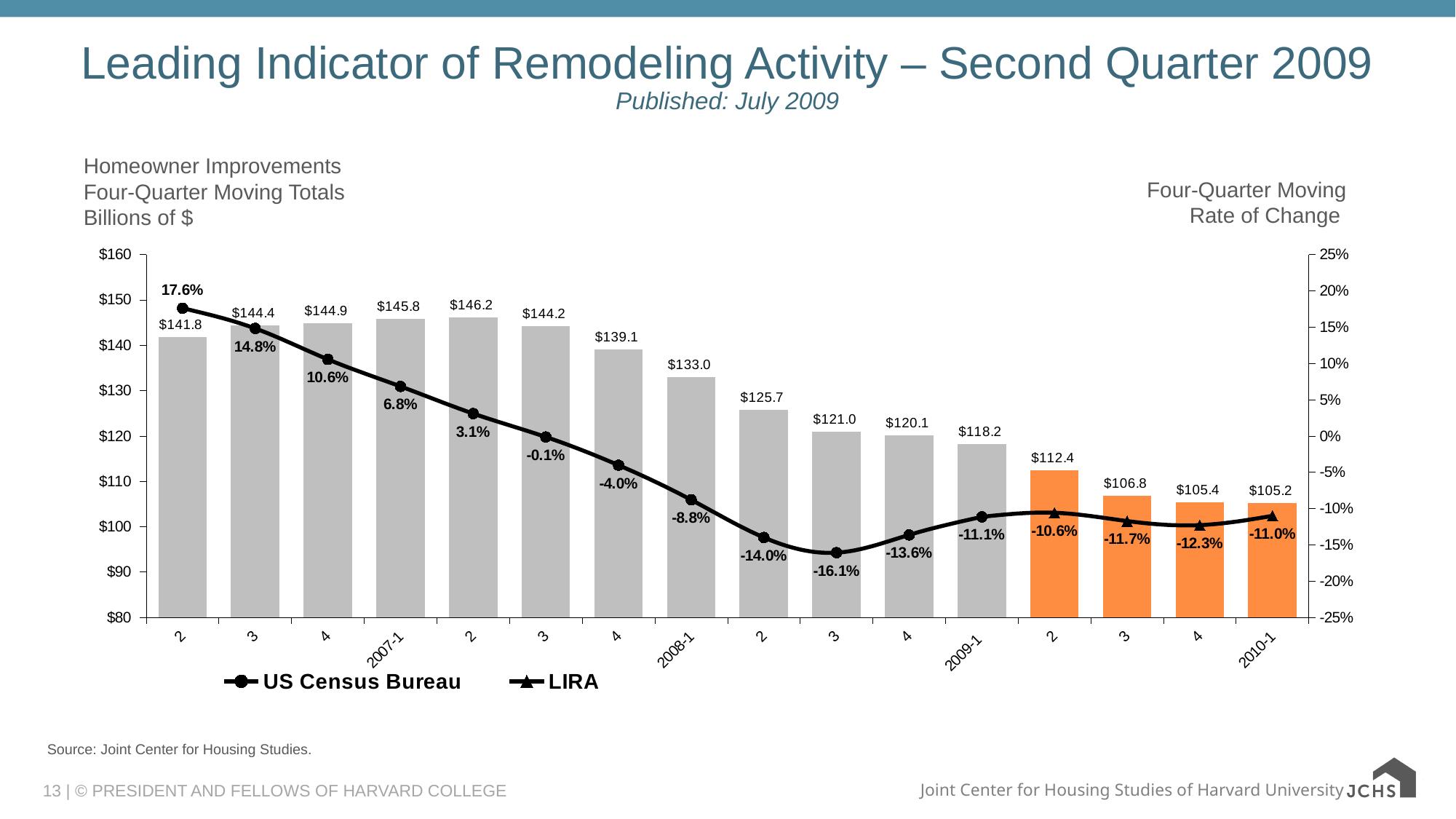
How many bars (quarters) are plotted in the chart? 16 What is the four-quarter moving total for 2010-1? $105.2 What is the four-quarter moving rate of change for 2009-1? -11.1% Which quarter has the lowest four-quarter moving rate of change on the line? 2008 quarter 3 (-16.1%) What kind of chart is shown on the slide? Combined bar and line chart What is the four-quarter moving total (in billions of $) for 2008-1? $133.0 Do the four-quarter moving totals generally rise or fall from 2007-1 to 2010-1? Fall What is the difference between the four-quarter moving totals for 2007-1 and 2008-1? $12.8 Which quarter has the highest four-quarter moving total bar? 2007 quarter 2 ($146.2) How many series does the legend list? 2 What are the two series named in the legend? US Census Bureau and LIRA Which is larger, the four-quarter moving total for 2009-1 or for 2010-1? 2009-1